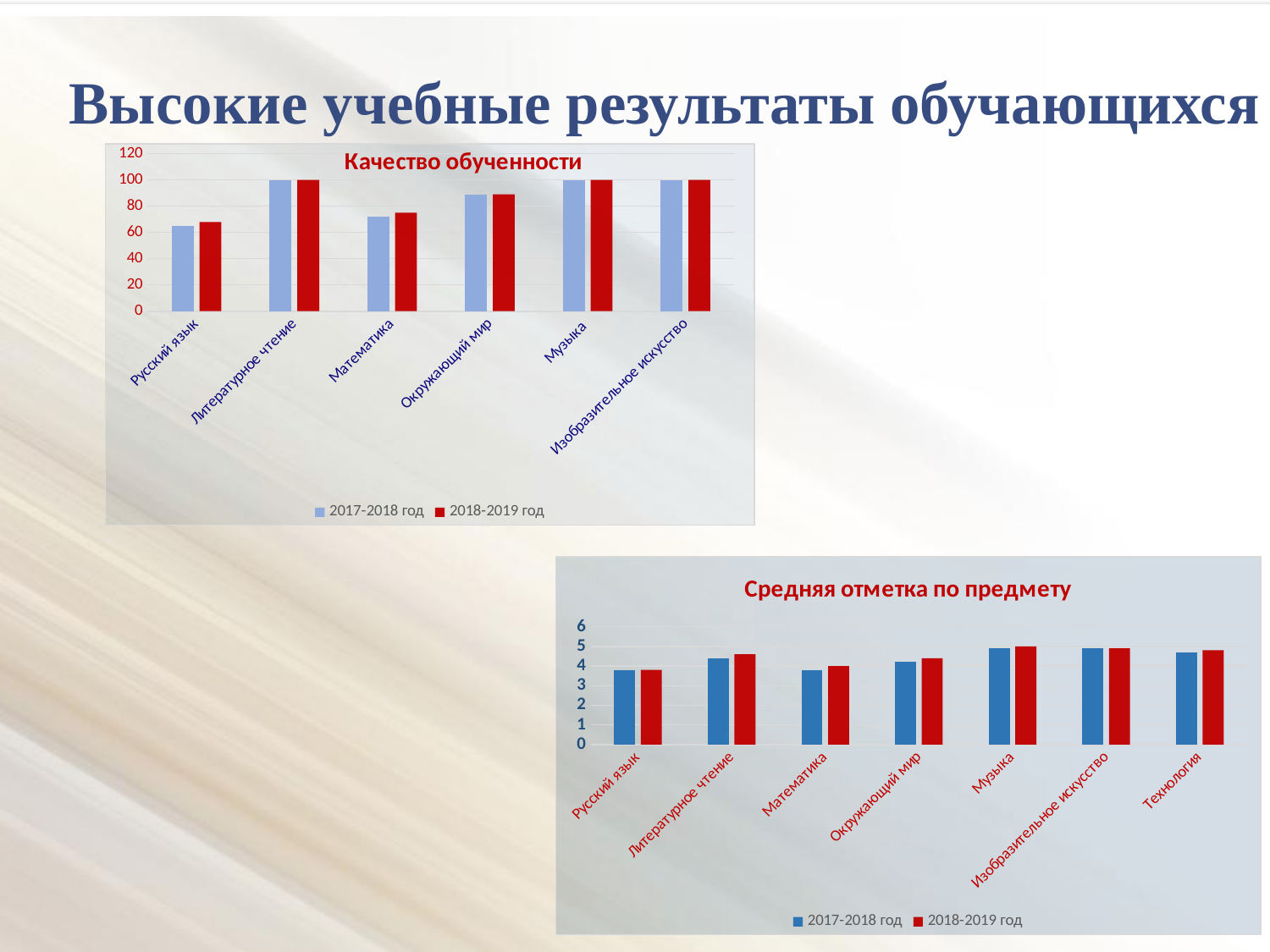
In the "Средняя отметка по предмету" chart, is the 2018-2019 год value for Музыка greater or less than 4? greater How many subjects are shown on the "Средняя отметка по предмету" chart? 7 In the "Качество обученности" chart, which is larger for 2018-2019 год: Русский язык or Математика? Математика In the "Качество обученности" chart, is the 2018-2019 год value for Окружающий мир greater or less than 80? greater What is the title of the lower chart on the slide? Средняя отметка по предмету In the "Качество обученности" chart, which subject has the lowest value for 2017-2018 год? Русский язык What type of chart is the "Качество обученности" chart? bar chart In the "Средняя отметка по предмету" chart, is the 2017-2018 год value for Русский язык greater or less than 4? less How many series does the legend of the "Качество обученности" chart list? 2 How many subjects are shown on the "Качество обученности" chart? 6 In the "Средняя отметка по предмету" chart, which is larger for 2018-2019 год: Математика or Музыка? Музыка